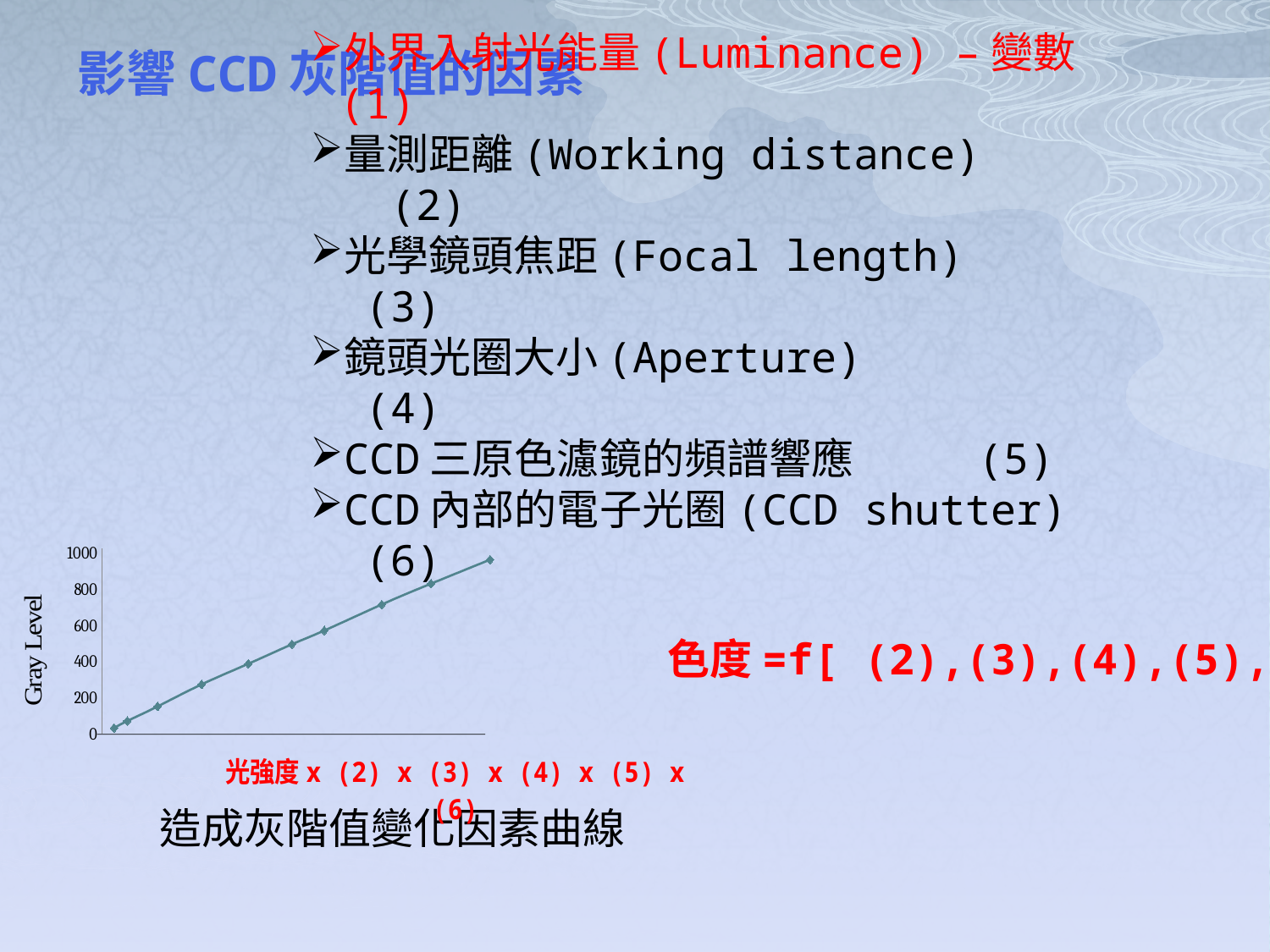
Is the value of the middle point of the line chart (around the centre of the x axis) greater or less than 200? greater Which point on the line chart has the lowest Gray Level, the leftmost or the rightmost? the leftmost Is the value of the leftmost point on the line chart greater or less than 200? less Do the values in the line chart rise or fall from left to right along the x axis? rise Is the value of the rightmost point on the line chart greater or less than 800? greater What kind of chart is shown at the bottom left of the slide? line chart Which point on the line chart has the highest Gray Level, the leftmost or the rightmost? the rightmost What is the label on the vertical axis of the line chart? Gray Level What is the highest tick value shown on the vertical axis of the line chart? 1000